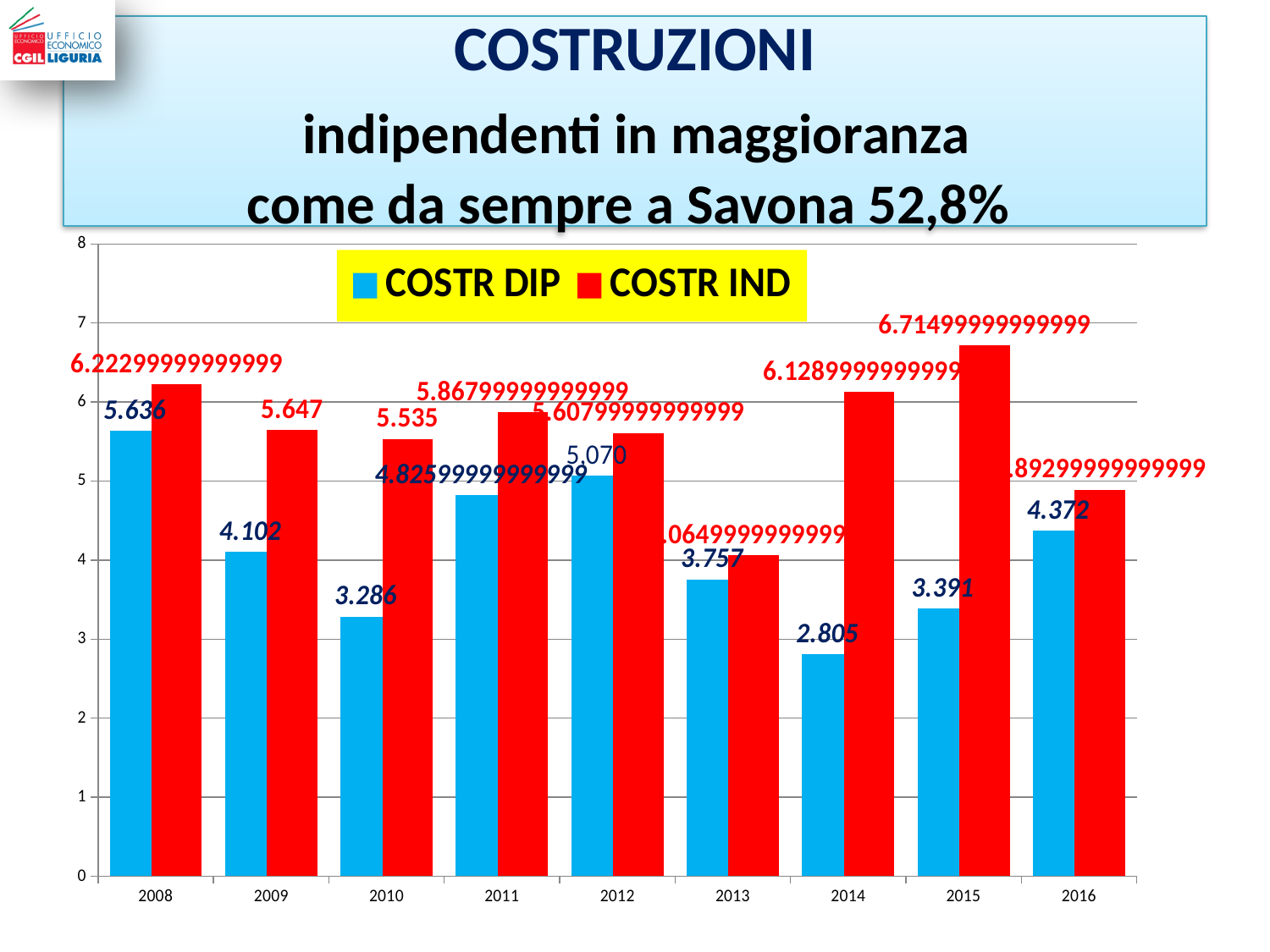
How many series does the legend list? 2 What is the value of COSTR DIP in 2008? 5.636 What type of chart is shown on the slide? bar chart What is the difference between COSTR IND and COSTR DIP in 2010? 2.249 What is the value of COSTR IND in 2010? 5.535 What is the value of COSTR DIP in 2014? 2.805 Which is larger in 2012, COSTR DIP or COSTR IND? COSTR IND How many years are shown on the x axis? 9 In which year is COSTR DIP lowest? 2014 What is the value of COSTR IND in 2009? 5.647 Is the value for COSTR IND in 2014 greater or less than 6? greater In which year is COSTR IND highest? 2015